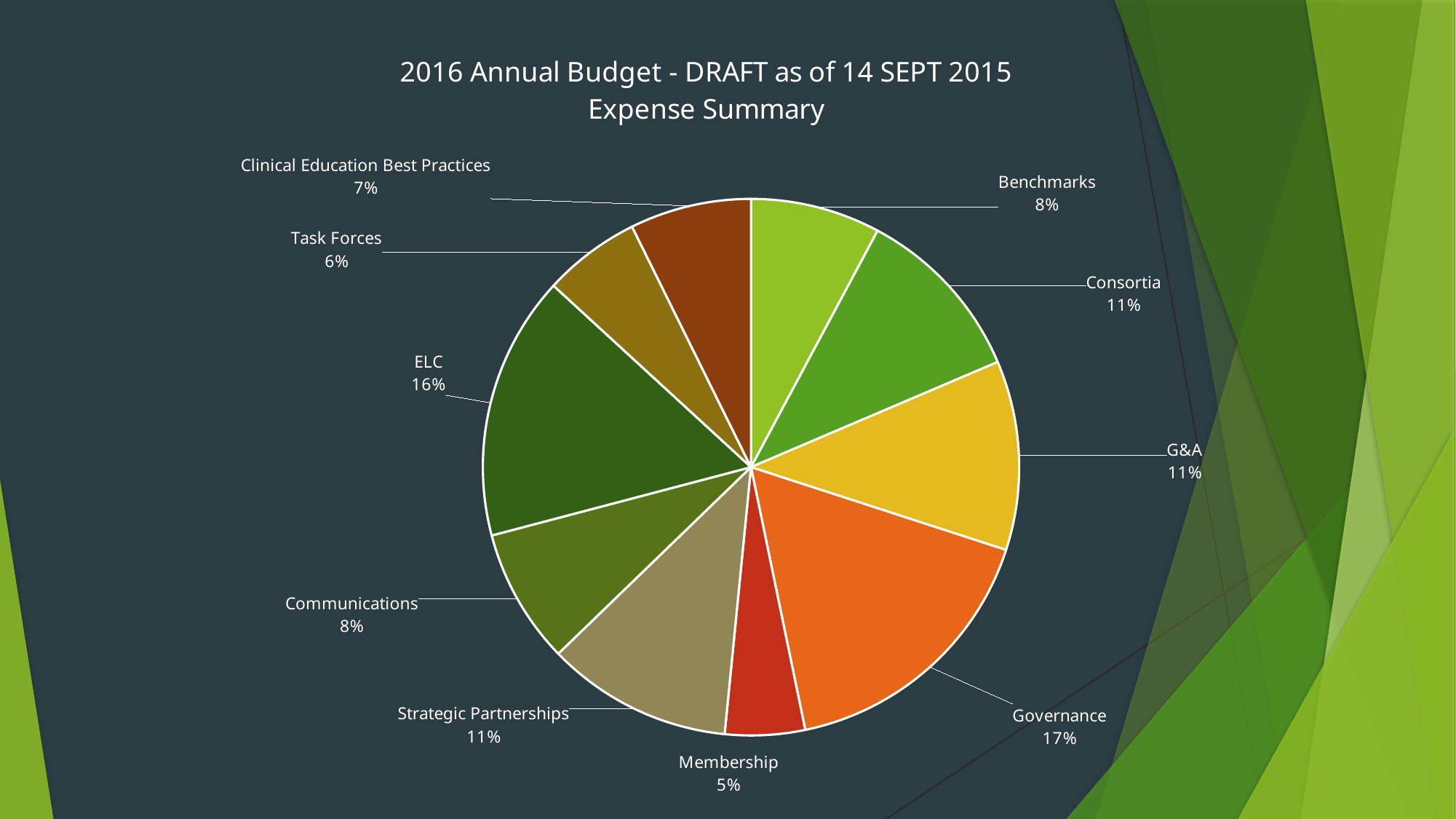
Which category has the largest share of the pie? Governance Which category has the smallest share of the pie? Membership What share of the expense summary is ELC? 16% What is the title of the chart? 2016 Annual Budget - DRAFT as of 14 SEPT 2015 Expense Summary What is the combined share of Benchmarks and Communications? 16% What is the difference in percentage points between Governance and Task Forces? 11 What kind of chart is shown on the slide? pie chart How many slices does the pie chart have? 10 What share of the expense summary is Governance? 17% Which is larger, the share for Communications or the share for Consortia? Consortia What percentage is shown for Membership? 5% What percentage is shown for Clinical Education Best Practices? 7%